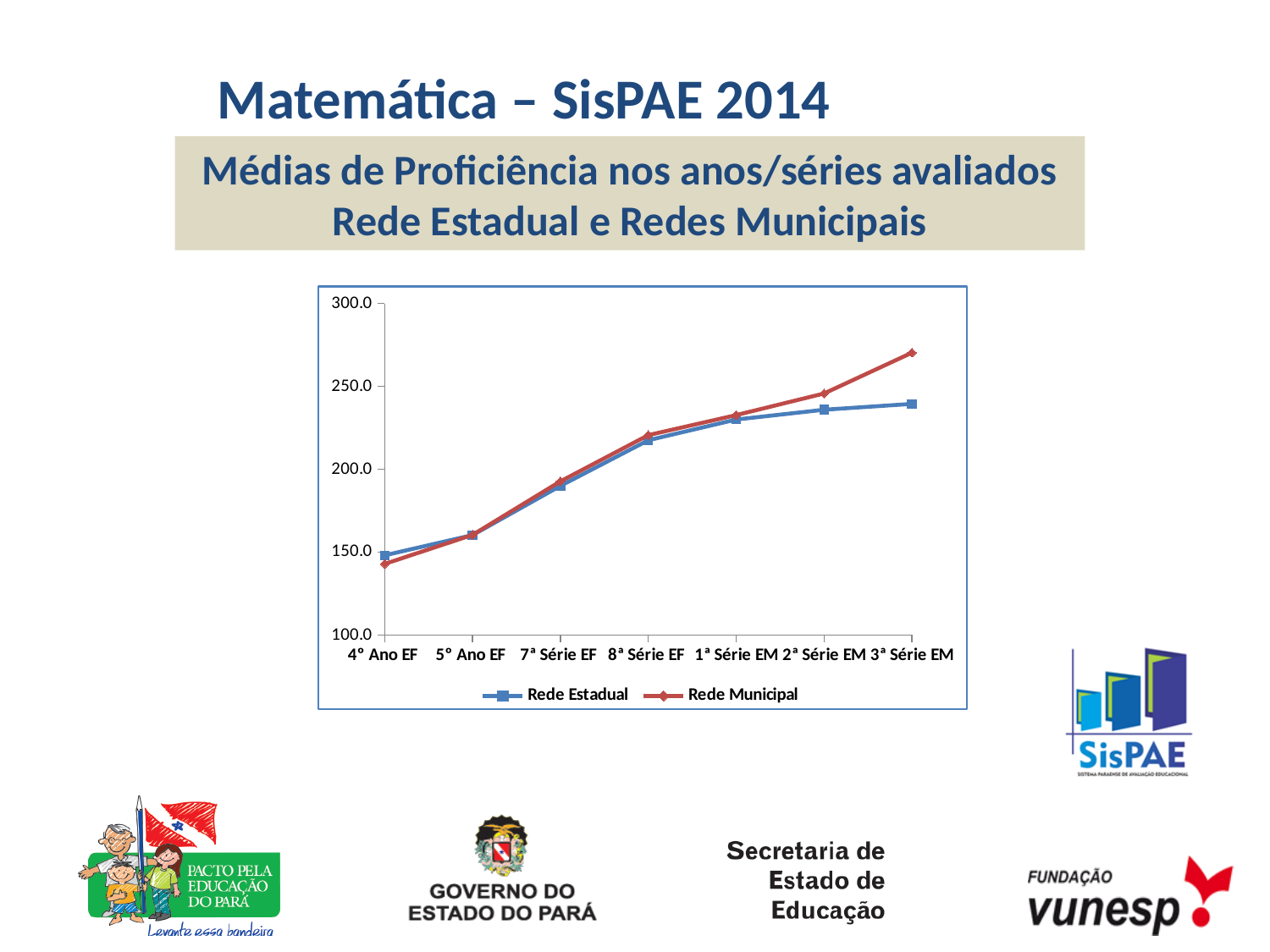
For which category is the Rede Municipal value highest? 3ª Série EM Do the values for Rede Municipal rise or fall from 4° Ano EF to 3ª Série EM? rise How many categories are shown on the x axis? 7 Is the value for Rede Municipal at 8ª Série EF greater or less than 200? greater Is the value for Rede Estadual at 3ª Série EM greater or less than 250? less What kind of chart is shown on the slide? line chart How many series does the legend list? 2 Is the value for Rede Municipal at 3ª Série EM greater or less than 250? greater Do the values for Rede Estadual rise or fall along the x axis? rise For which category is the Rede Estadual value lowest? 4° Ano EF At 3ª Série EM, which series has the larger value, Rede Estadual or Rede Municipal? Rede Municipal